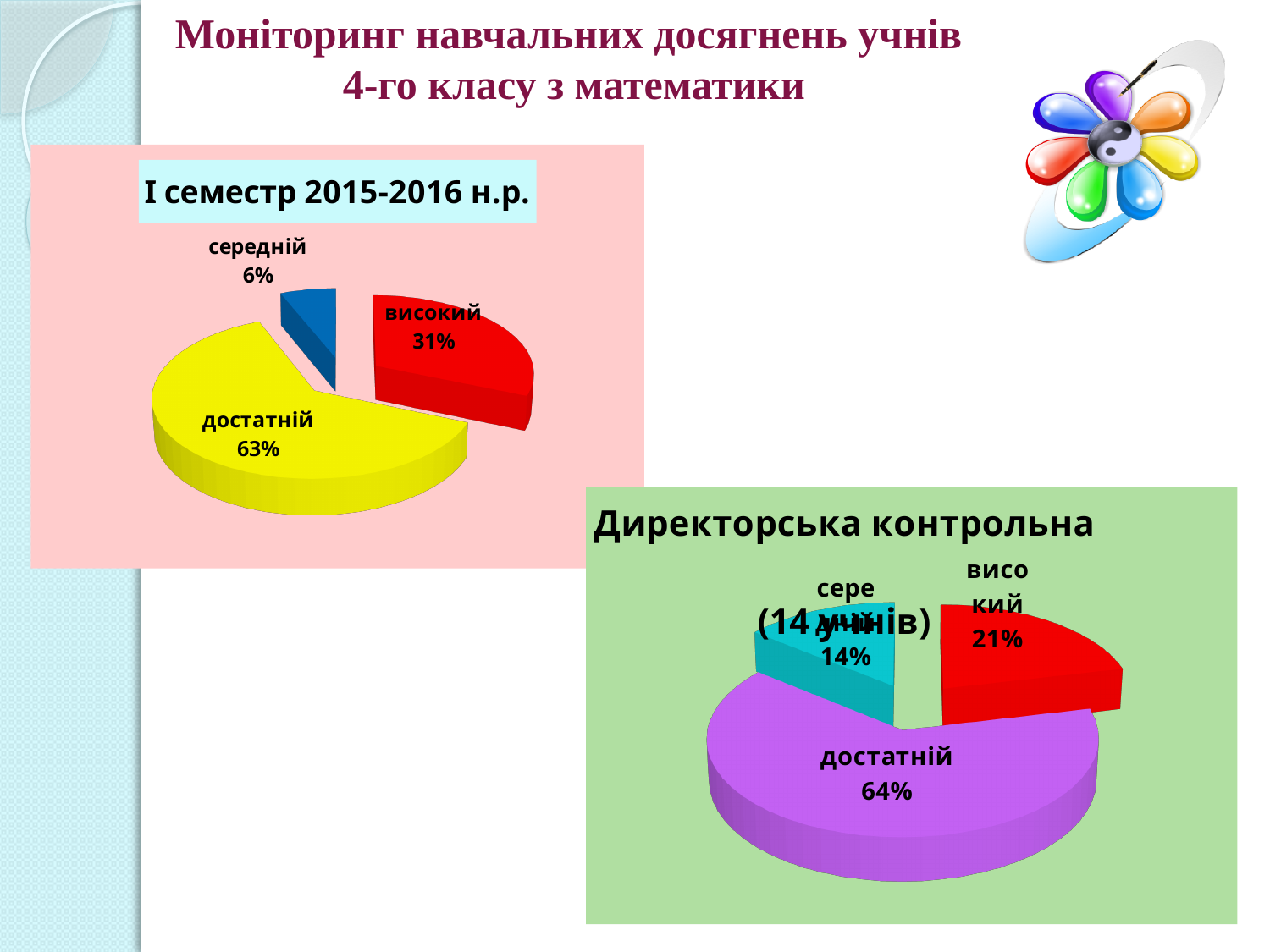
How many categories does the chart titled "І семестр 2015-2016 н.р." show? 3 In the chart titled "І семестр 2015-2016 н.р.", what is the value for "середній"? 6% In the chart titled "І семестр 2015-2016 н.р.", which category has the largest share? достатній In the chart titled "Директорська контрольна", which is larger, "високий" or "середній"? високий In the chart titled "І семестр 2015-2016 н.р.", what is the value for "високий"? 31% In the chart titled "І семестр 2015-2016 н.р.", what share of the pie is "достатній"? 63% In the chart titled "І семестр 2015-2016 н.р.", which category has the smallest share? середній In the chart titled "Директорська контрольна", which category has the largest share? достатній In the chart titled "І семестр 2015-2016 н.р.", what is the difference between "достатній" and "високий"? 32% What kind of chart is the chart titled "Директорська контрольна"? pie chart In the chart titled "Директорська контрольна", what is the value for "достатній"? 64% In the chart titled "Директорська контрольна", what is the value for "високий"? 21%